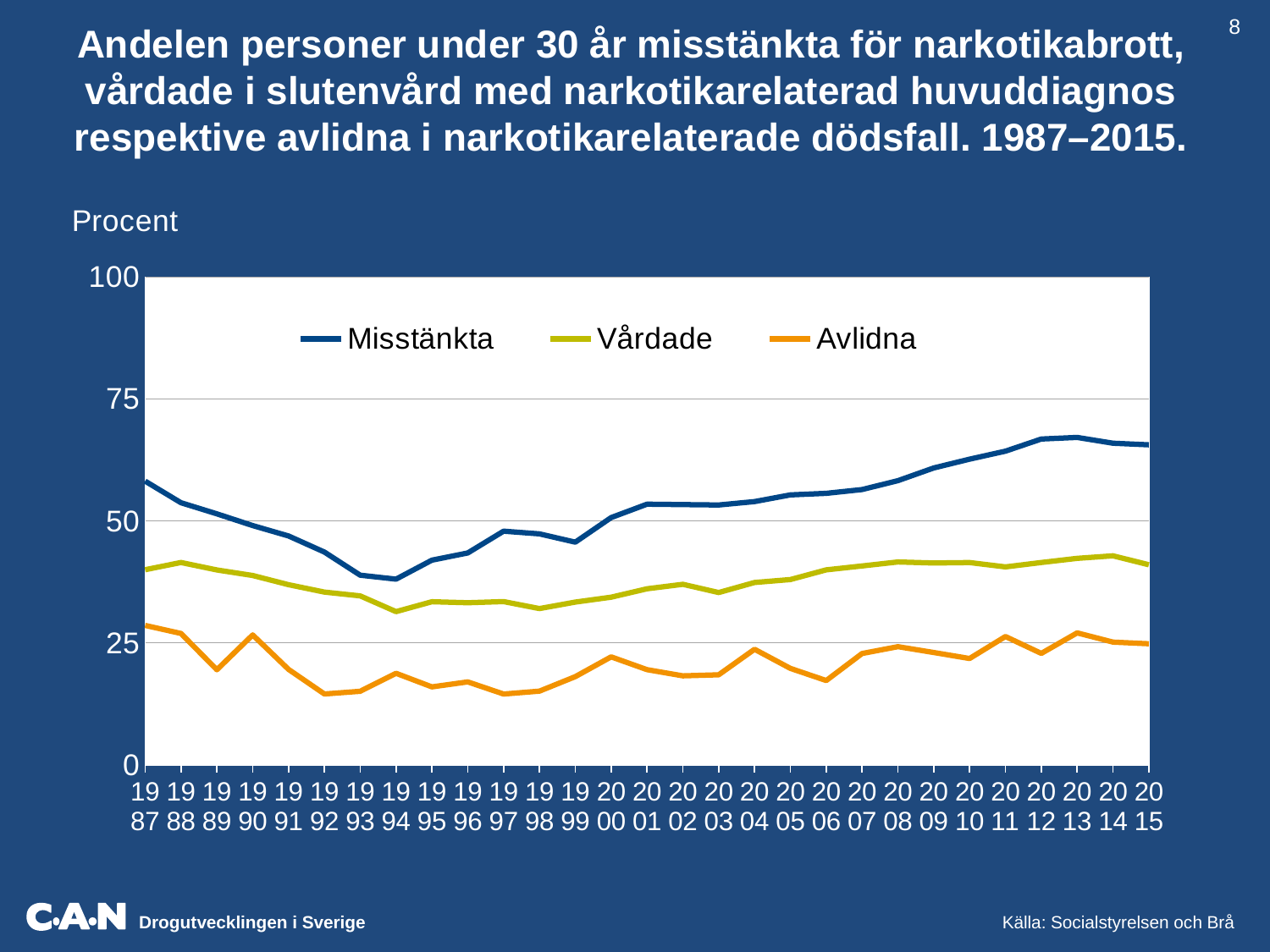
Is the value for Vårdade in 2013 greater or less than 50? less Does the Misstänkta line rise or fall from 2000 to 2012? rise What kind of chart is shown on the slide? line chart What label is shown on the y axis of the chart? Procent Is the value for Misstänkta in 1994 greater or less than 50? less Which series has the highest value in 2015? Misstänkta Which series has the lowest value in 2015? Avlidna Which is larger in 2000, the value for Vårdade or the value for Avlidna? Vårdade Is the value for Avlidna in 1992 greater or less than 25? less How many years are plotted along the x axis? 29 How many series does the legend list? 3